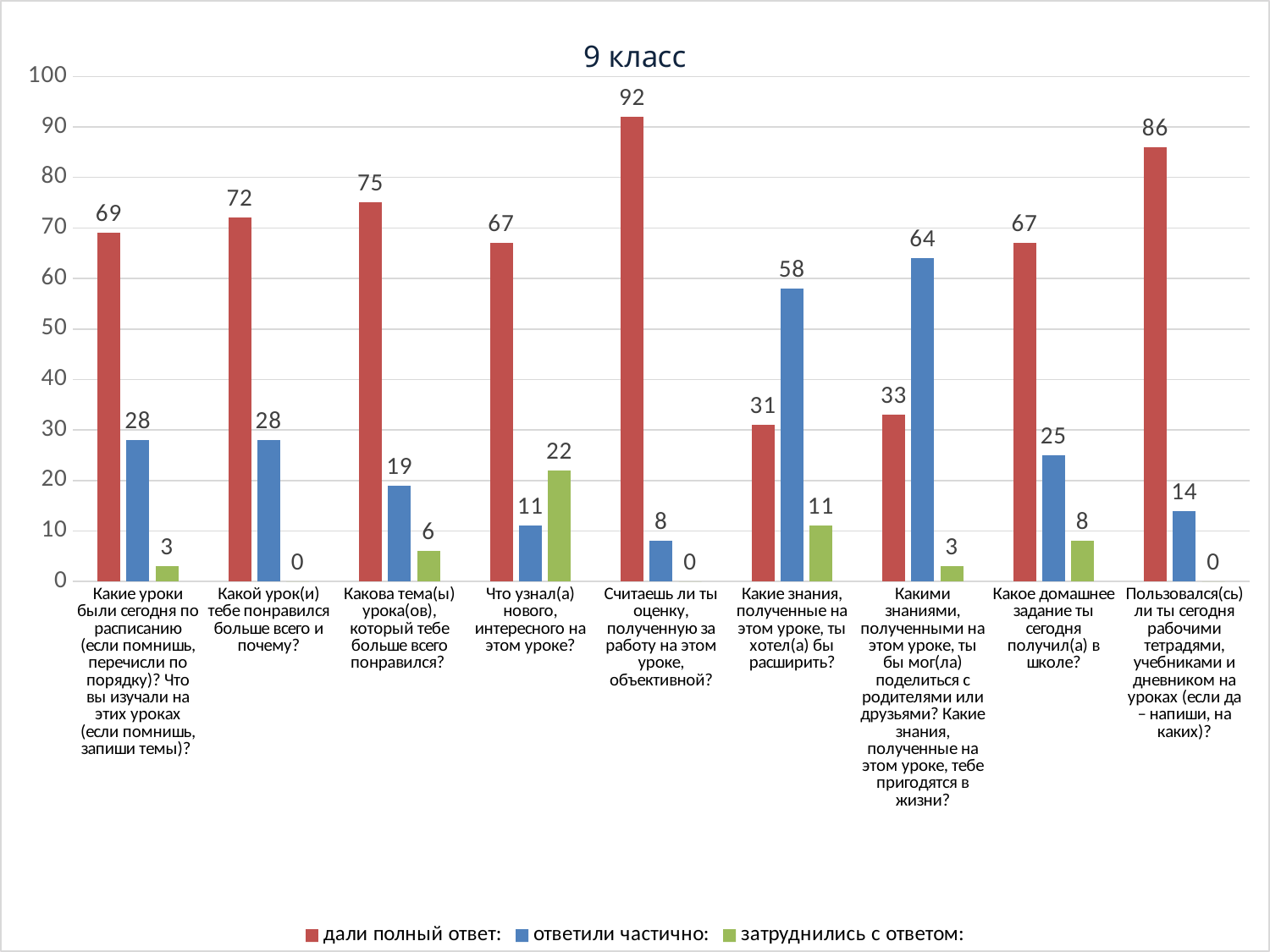
Which question has the lowest value for "дали полный ответ"? Какие знания, полученные на этом уроке, ты хотел(а) бы расширить? What is the total of the three series for "Какое домашнее задание ты сегодня получил(а) в школе?"? 100 For "Какие знания, полученные на этом уроке, ты хотел(а) бы расширить?", which is larger: "дали полный ответ" or "ответили частично"? ответили частично What is the value of "затруднились с ответом" for "Что узнал(а) нового, интересного на этом уроке?"? 22 What is the value of "ответили частично" for "Какими знаниями, полученными на этом уроке, ты бы мог(ла) поделиться с родителями или друзьями?"? 64 What is the title of the chart? 9 класс What is the value of "дали полный ответ" for "Считаешь ли ты оценку, полученную за работу на этом уроке, объективной?"? 92 What type of chart is shown on the slide? bar chart What is the difference between "дали полный ответ" and "ответили частично" for "Пользовался(сь) ли ты сегодня рабочими тетрадями, учебниками и дневником на уроках?"? 72 How many series does the legend list? 3 How many question categories are shown on the x axis? 9 Which question has the highest value for "дали полный ответ"? Считаешь ли ты оценку, полученную за работу на этом уроке, объективной?